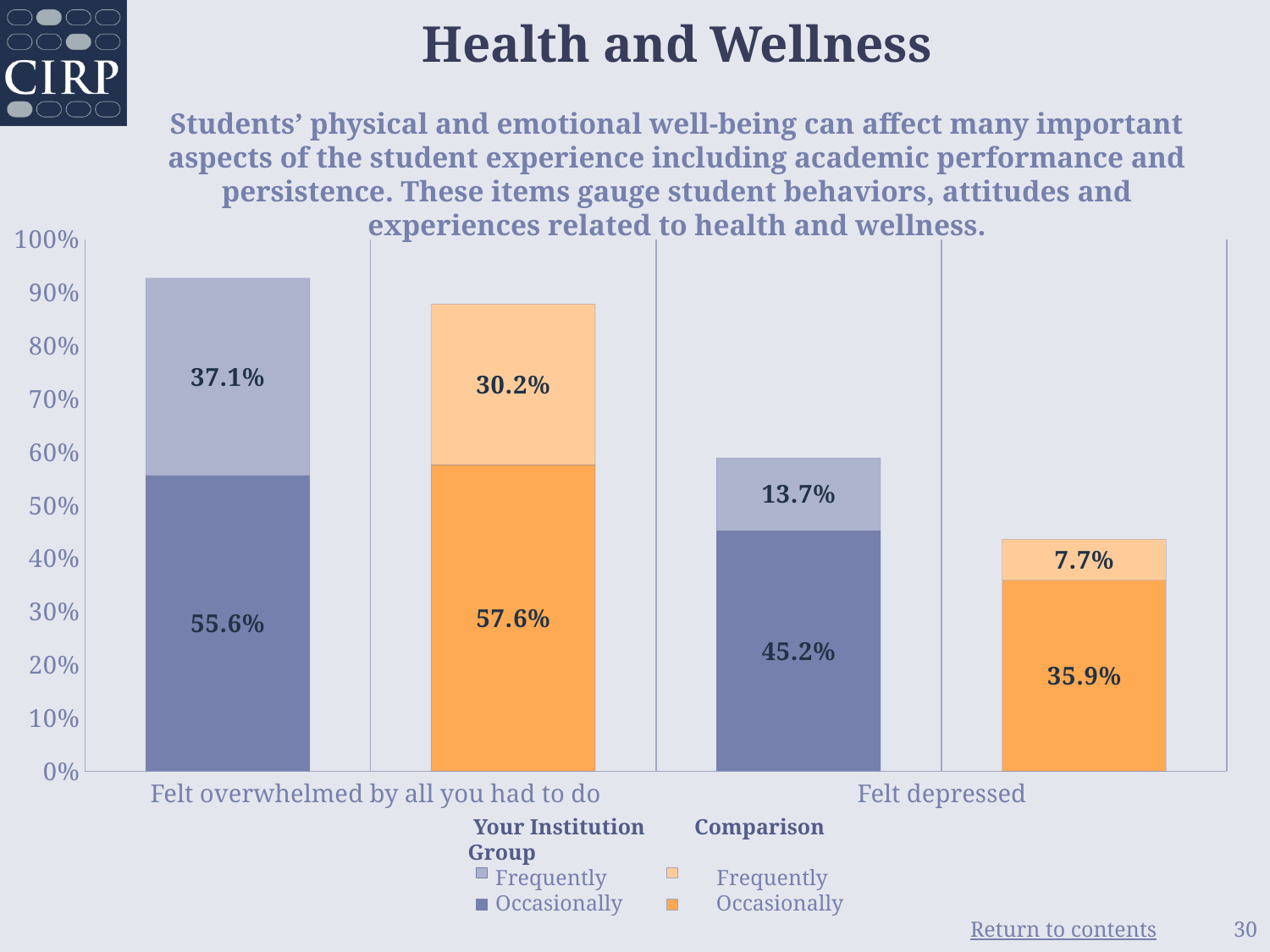
How many series does the legend list? 4 Which stacked bar is the tallest overall? Your Institution, Felt overwhelmed by all you had to do What percentage of students at Your Institution occasionally felt overwhelmed by all they had to do? 55.6% What is the total percentage of the Comparison Group who felt depressed (frequently plus occasionally)? 43.6% Which is larger for occasionally feeling depressed: Your Institution or the Comparison Group? Your Institution What is the difference between the Your Institution and Comparison Group percentages for frequently feeling overwhelmed? 6.9% What percentage of the Comparison Group frequently felt depressed? 7.7% What is the title of the slide containing the chart? Health and Wellness What type of chart is shown on the slide? Stacked bar chart What percentage of students at Your Institution frequently felt overwhelmed by all they had to do? 37.1% What is the total percentage of Your Institution students who felt overwhelmed (frequently plus occasionally)? 92.7% What percentage of the Comparison Group occasionally felt depressed? 35.9%